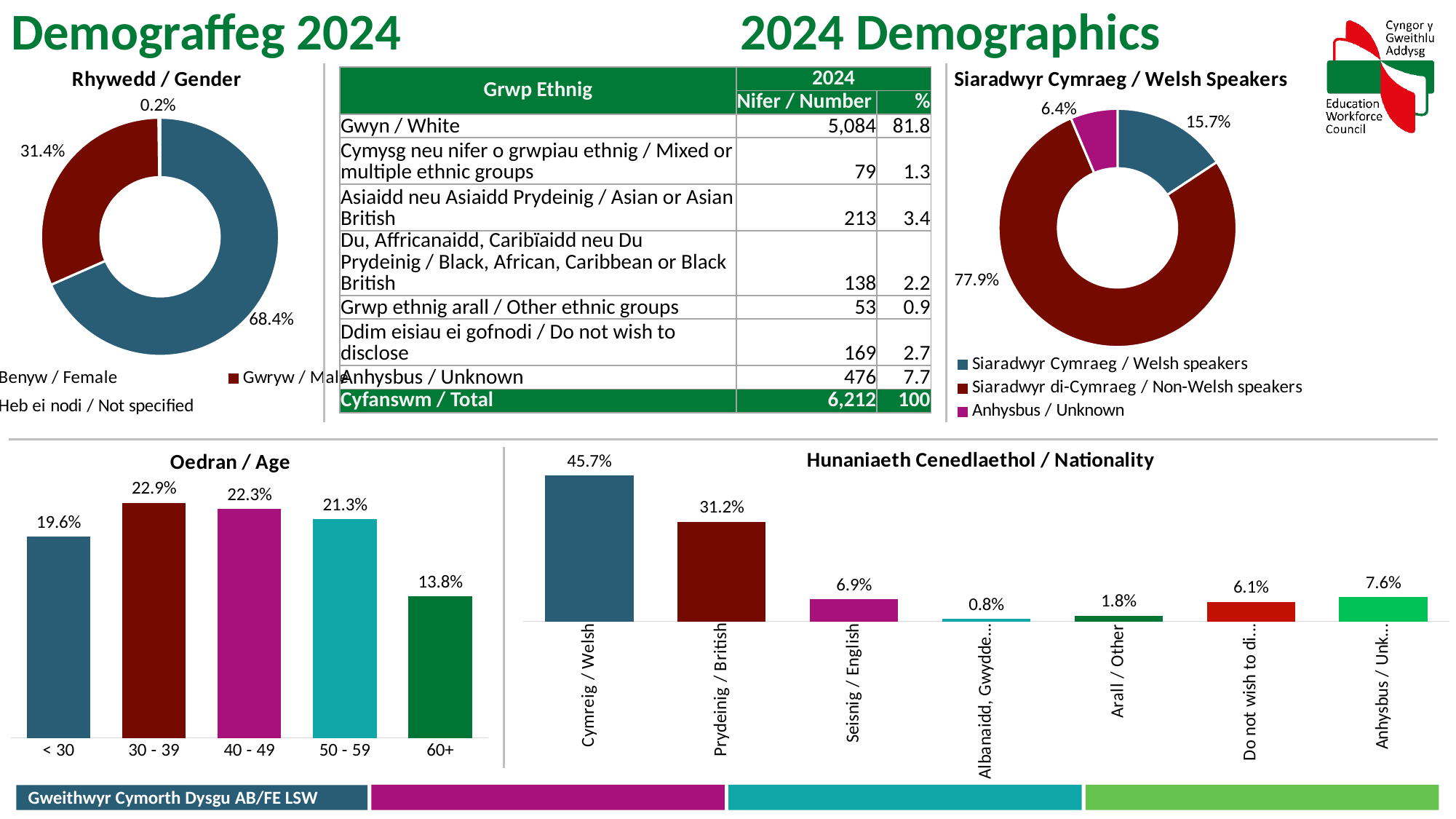
How many age groups are shown in the Oedran / Age chart? 5 In the Oedran / Age chart, what is the difference between the < 30 and 60+ values? 5.8% In the Hunaniaeth Cenedlaethol / Nationality chart, which is larger, Seisnig / English or Arall / Other? Seisnig / English In the Oedran / Age chart, what is the value for the 30 - 39 group? 22.9% In the Siaradwyr Cymraeg / Welsh Speakers chart, what percentage is shown for Siaradwyr di-Cymraeg / Non-Welsh speakers? 77.9% How many categories does the legend of the Siaradwyr Cymraeg / Welsh Speakers chart list? 3 In the Siaradwyr Cymraeg / Welsh Speakers chart, which category has the smallest share? Anhysbus / Unknown In the Hunaniaeth Cenedlaethol / Nationality chart, what is the value for Cymreig / Welsh? 45.7% In the Rhywedd / Gender chart, what share is shown for Gwryw / Male? 31.4% In the Oedran / Age chart, which age group has the lowest value? 60+ What kind of chart is the Rhywedd / Gender chart? Doughnut chart In the Rhywedd / Gender chart, what share is labelled for Benyw / Female? 68.4%